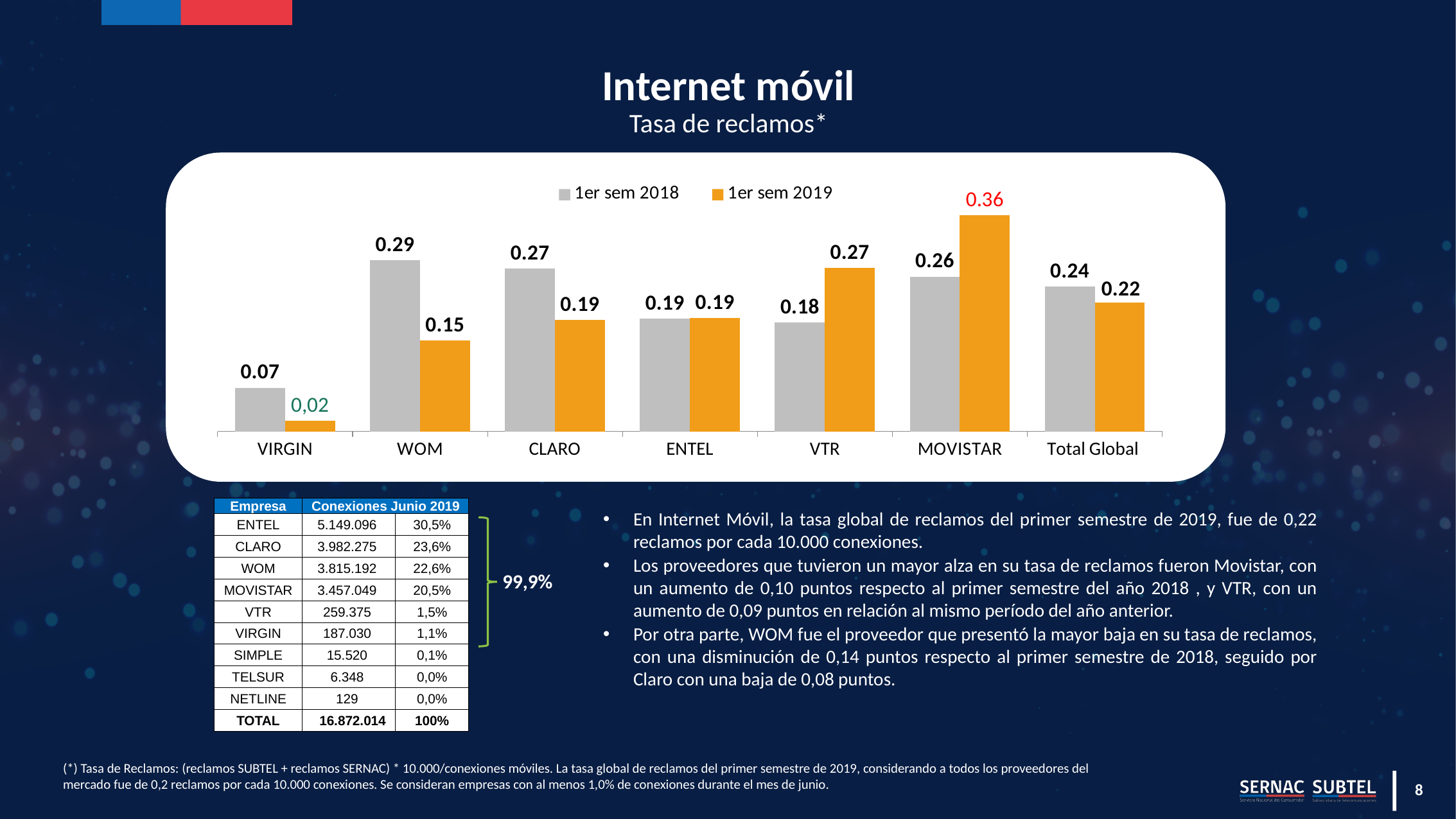
How many categories are shown on the x axis of the chart? 7 What is the value for WOM in the 1er sem 2018 series? 0.29 What is the value for VIRGIN in the 1er sem 2019 series? 0,02 What kind of chart is shown on the slide? Bar chart What is the value for Total Global in the 1er sem 2019 series? 0.22 Which category has the lowest value in the 1er sem 2018 series? VIRGIN What is the difference between the 1er sem 2018 and 1er sem 2019 values for WOM? 0.14 How many series does the chart legend list? 2 Which category has the highest value in the 1er sem 2019 series? MOVISTAR What is the value for MOVISTAR in the 1er sem 2019 series? 0.36 Which is larger for VTR: the 1er sem 2018 value or the 1er sem 2019 value? 1er sem 2019 What is the difference between the 1er sem 2019 and 1er sem 2018 values for MOVISTAR? 0.10